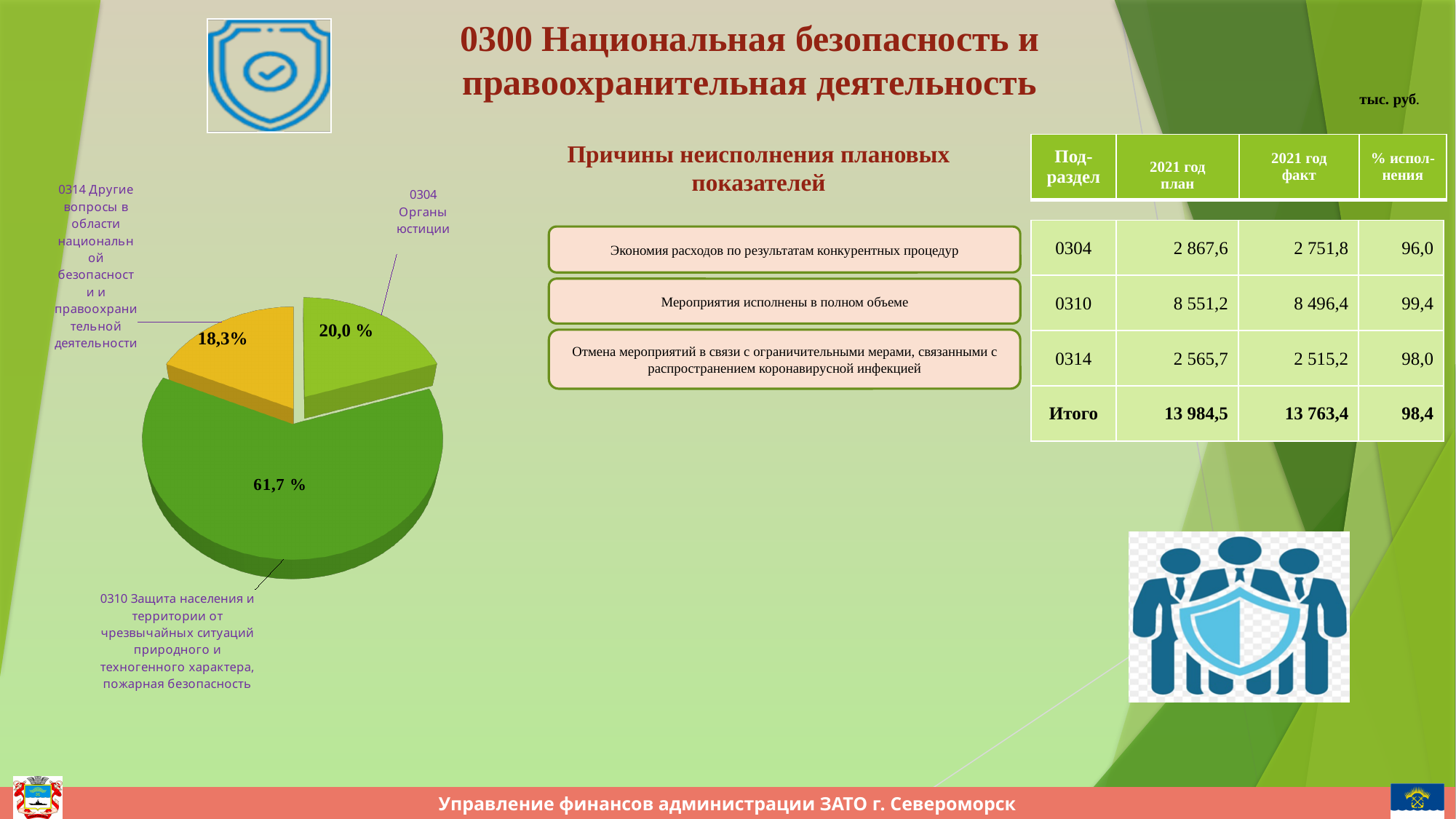
What colour is the slice for 0314 Другие вопросы in the pie chart? yellow What share of the pie does the slice for 0310 Защита населения и территории от чрезвычайных ситуаций природного и техногенного характера, пожарная безопасность have? 61,7 % What share of the pie does the slice for 0304 Органы юстиции have? 20,0 % Which slice of the pie chart is the largest? 0310 Защита населения и территории от чрезвычайных ситуаций природного и техногенного характера, пожарная безопасность What kind of chart is shown on the left of the slide? pie chart Which slice is larger in the pie chart: 0304 Органы юстиции or 0314 Другие вопросы? 0304 Органы юстиции What share of the pie does the slice for 0314 Другие вопросы в области национальной безопасности и правоохранительной деятельности have? 18,3% How many slices does the pie chart have? 3 What colour is the largest slice of the pie chart? green What is the difference in percentage points between the 0304 slice and the 0314 slice in the pie chart? 1,7 What is the difference in percentage points between the 0310 slice and the 0304 slice in the pie chart? 41,7 Which slice of the pie chart is the smallest? 0314 Другие вопросы в области национальной безопасности и правоохранительной деятельности